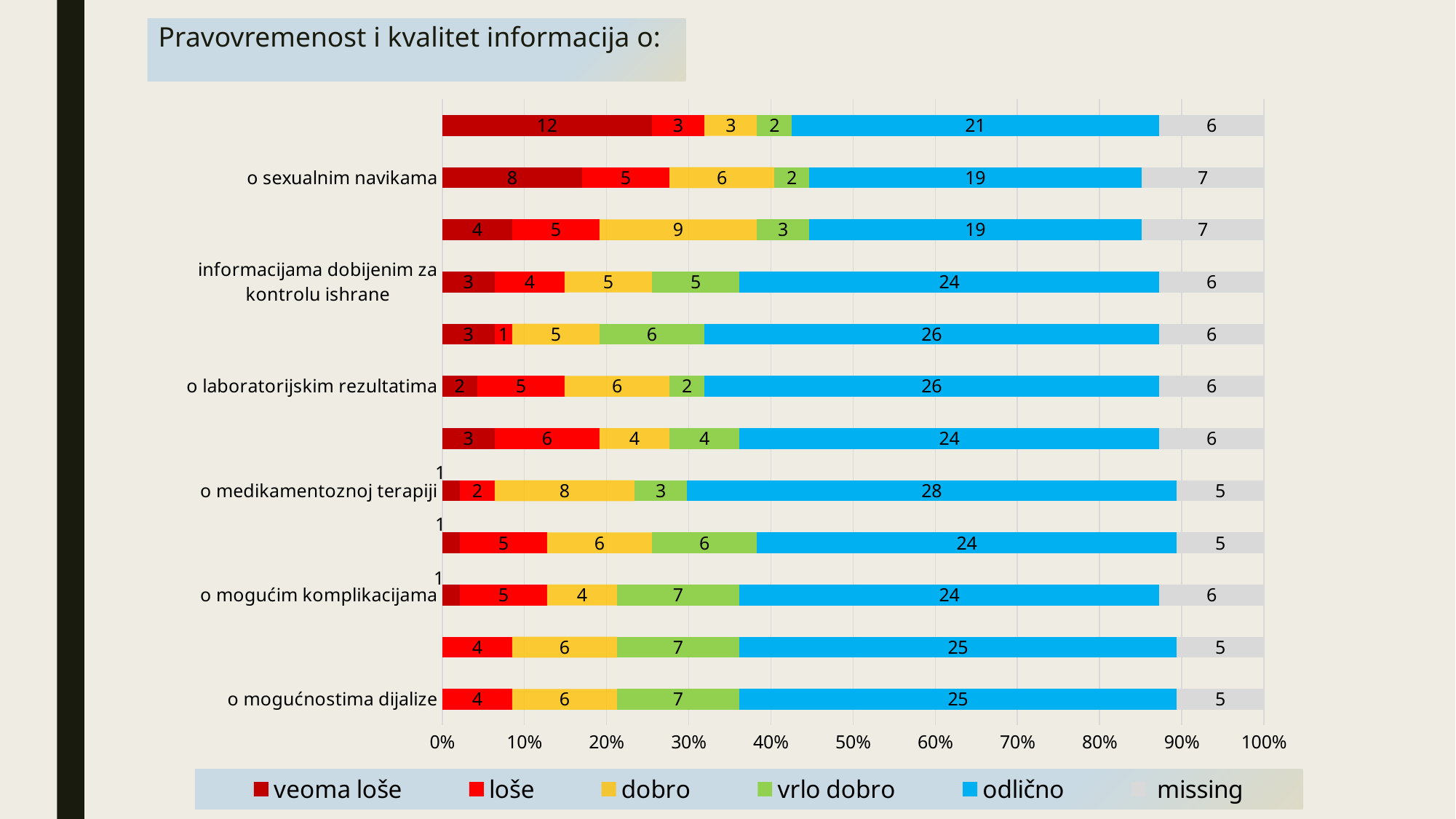
What is the title of the chart? Pravovremenost i kvalitet informacija o: What is the value of 'odlično' for 'o medikamentoznoj terapiji'? 28 What is the difference between the 'odlično' values for 'o medikamentoznoj terapiji' and 'o sexualnim navikama'? 9 Which is larger: the 'dobro' value for 'o medikamentoznoj terapiji' or for 'o mogućim komplikacijama'? o medikamentoznoj terapiji What is the value of 'veoma loše' for 'o sexualnim navikama'? 8 What is the total of all segments in the bar for 'o mogućnostima dijalize'? 47 What kind of chart is shown on the slide? stacked bar chart What is the value of 'missing' for 'o laboratorijskim rezultatima'? 6 What is the value of 'odlično' for 'o sexualnim navikama'? 19 How many series does the legend list? 6 How many bars are plotted in the chart? 12 What is the value of 'vrlo dobro' for 'o mogućim komplikacijama'? 7